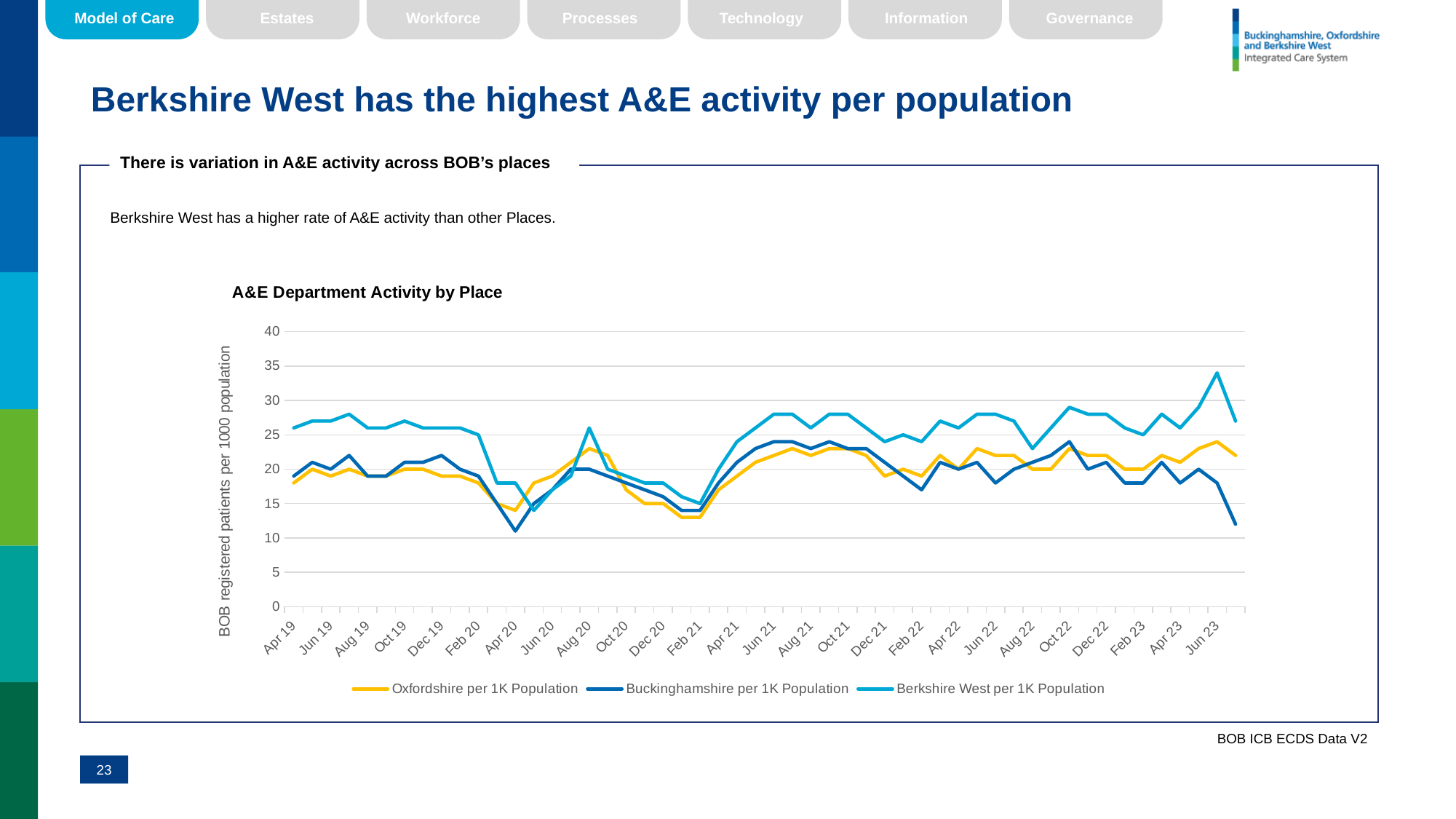
In the 'A&E Department Activity by Place' chart, is the value for Oxfordshire per 1K Population at Apr 19 greater or less than 20? less What kind of chart is 'A&E Department Activity by Place'? line chart In the 'A&E Department Activity by Place' chart, which is larger at Apr 20: Oxfordshire per 1K Population or Buckinghamshire per 1K Population? Oxfordshire per 1K Population How many series does the legend of the 'A&E Department Activity by Place' chart list? 3 What is the y-axis label of the 'A&E Department Activity by Place' chart? BOB registered patients per 1000 population Which series in the 'A&E Department Activity by Place' chart has the highest values across most of the period? Berkshire West per 1K Population In the 'A&E Department Activity by Place' chart, is the value for Buckinghamshire per 1K Population at Apr 20 greater or less than 15? less In the 'A&E Department Activity by Place' chart, is the value for Berkshire West per 1K Population at Jun 23 greater or less than 30? greater In the 'A&E Department Activity by Place' chart, does the Buckinghamshire per 1K Population line rise or fall between Apr 23 and the final point? fall In the 'A&E Department Activity by Place' chart, which is larger at Apr 19: Berkshire West per 1K Population or Oxfordshire per 1K Population? Berkshire West per 1K Population How many month labels are shown on the x axis of the 'A&E Department Activity by Place' chart? 26